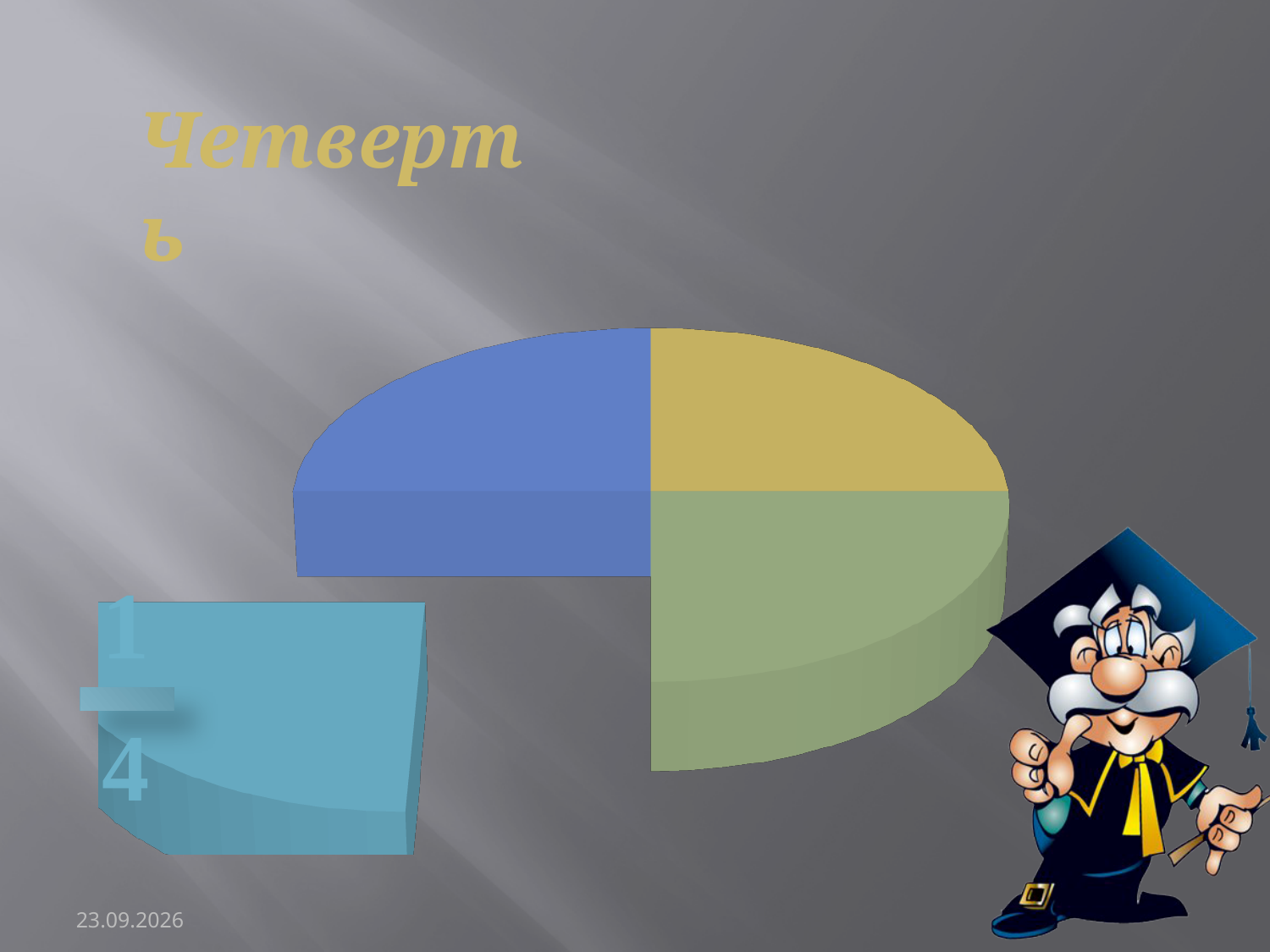
What fraction is printed on the separated slice at the bottom left of the pie chart? 1/4 How many slices remain in the main body of the pie chart, not counting the separated slice? 3 What is the title shown above the pie chart? Четверть What kind of chart is shown on the slide? pie chart What colour is the slice in the upper-right quarter of the pie chart? yellow How many slices does the pie chart have in total, including the separated slice labelled 1/4? 4